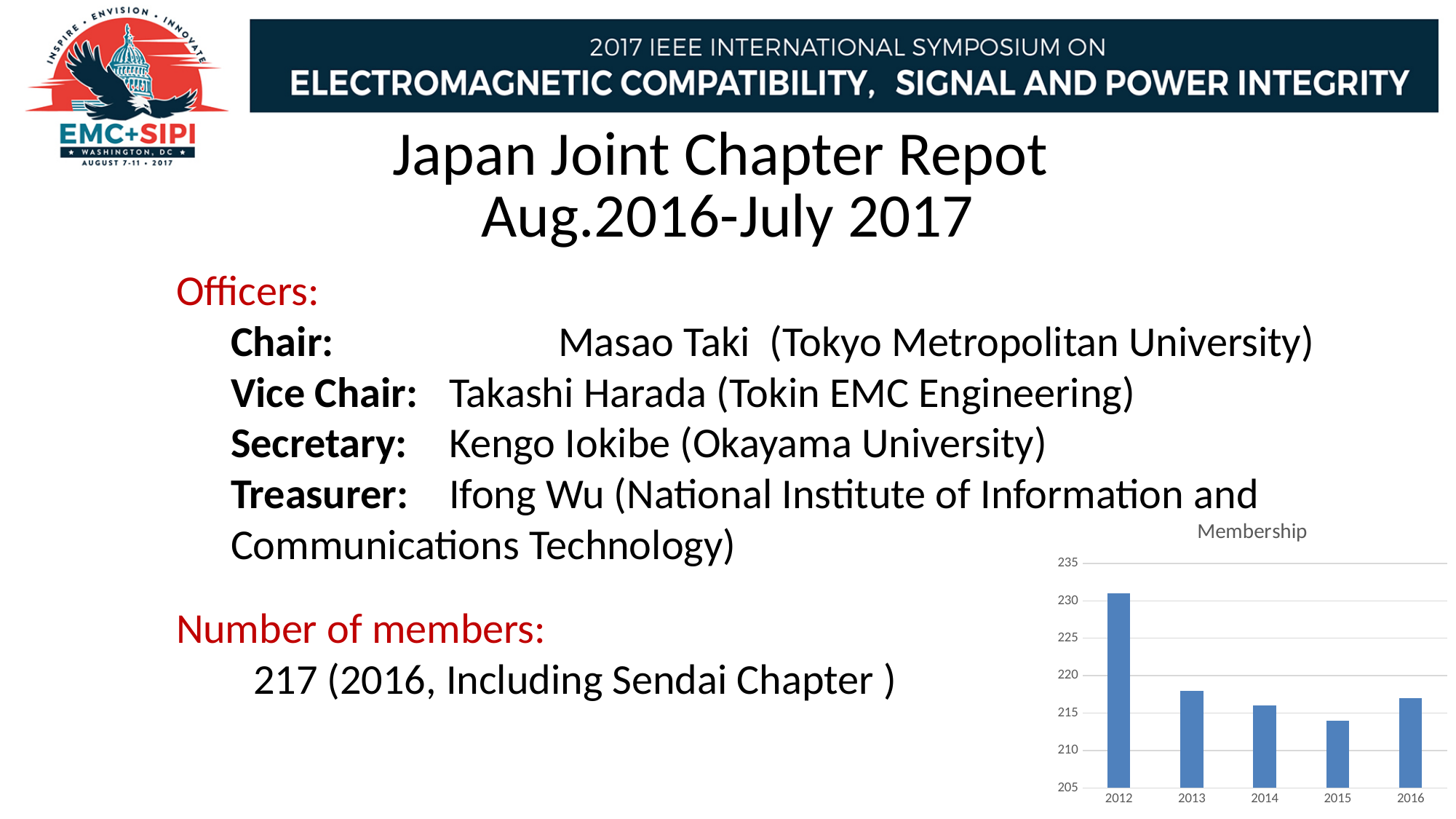
What kind of chart is shown on the slide? bar chart Is the membership value for 2016 greater or less than 215? greater Which year has the highest membership in the chart? 2012 How many years are shown on the x axis of the Membership chart? 5 Which year has the lowest membership in the chart? 2015 Is the membership value for 2013 greater or less than 220? less Is the membership value for 2015 greater or less than 215? less Which year has a larger membership, 2013 or 2015? 2013 Which year has a larger membership, 2012 or 2013? 2012 What is the title of the chart on the slide? Membership Does membership rise or fall from 2012 to 2015 in the chart? fall